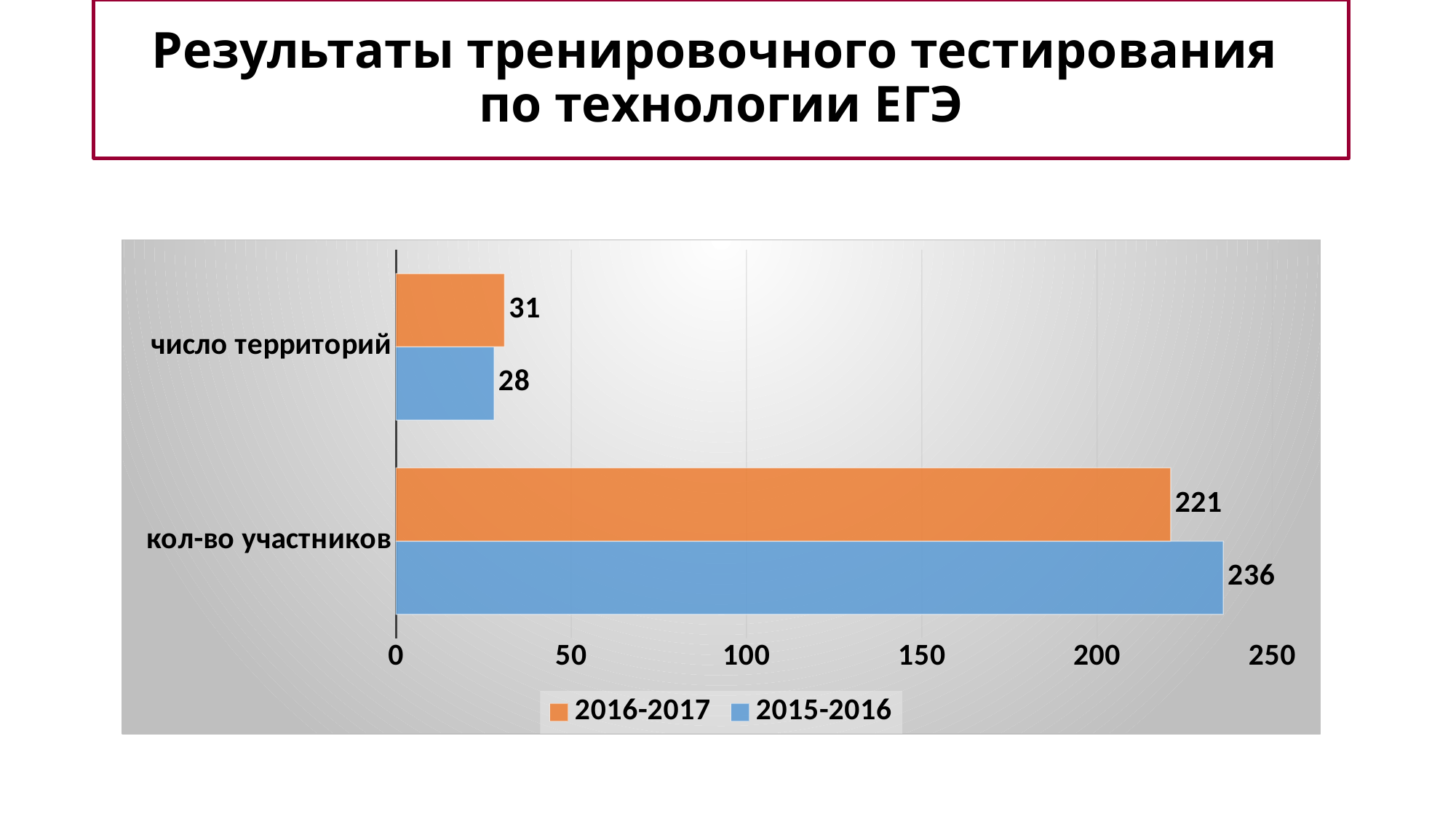
Which colour represents the 2016-2017 series? Orange What kind of chart is shown on the slide? Bar chart What is the value for "число территорий" in the 2015-2016 series? 28 What is the difference between the 2016-2017 and 2015-2016 values for "число территорий"? 3 What is the value for "кол-во участников" in the 2015-2016 series? 236 Which series has the higher value for "число территорий"? 2016-2017 What is the difference between the 2015-2016 and 2016-2017 values for "кол-во участников"? 15 What is the value for "кол-во участников" in the 2016-2017 series? 221 How many categories are shown on the chart? 2 How many series does the legend list? 2 What is the value for "число территорий" in the 2016-2017 series? 31 Which series has the higher value for "кол-во участников"? 2015-2016